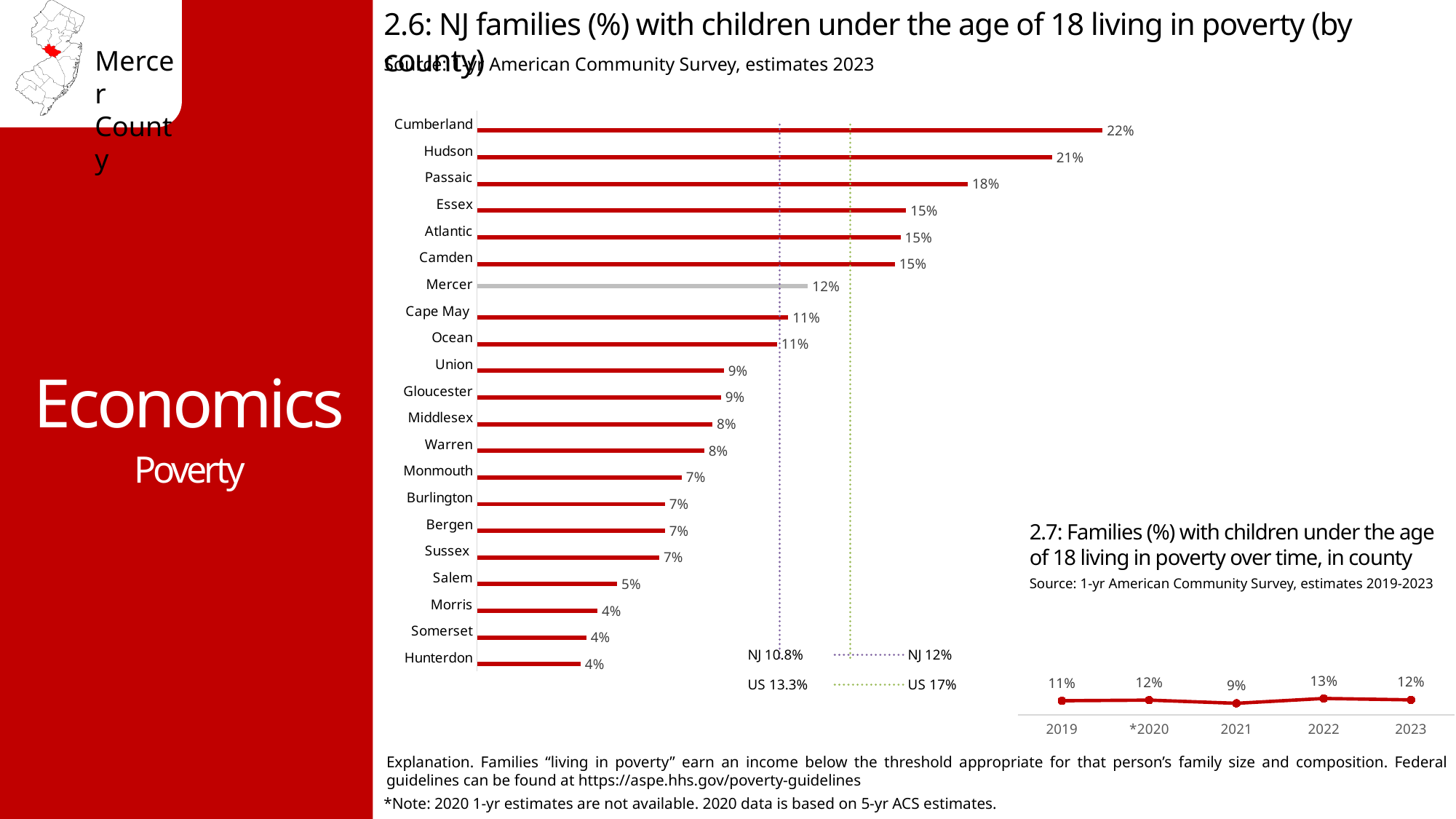
In chart 2.6, how many counties are plotted? 21 In chart 2.7, which year has the lowest value? 2021 In chart 2.7, how many years are plotted? 5 In chart 2.6, which county has the highest percentage of families with children living in poverty? Cumberland In chart 2.7, what is the difference between the 2022 and 2021 values? 4% What kind of chart is chart 2.6? Bar chart In chart 2.6, which has a higher value, Essex or Union? Essex In chart 2.7, what was the percentage of families with children living in poverty in 2022? 13% In chart 2.6, what is the value shown for Mercer? 12% In chart 2.6, what is the difference between the values for Hudson and Passaic? 3% In chart 2.6, what percentage of families with children under 18 live in poverty in Cumberland? 22%